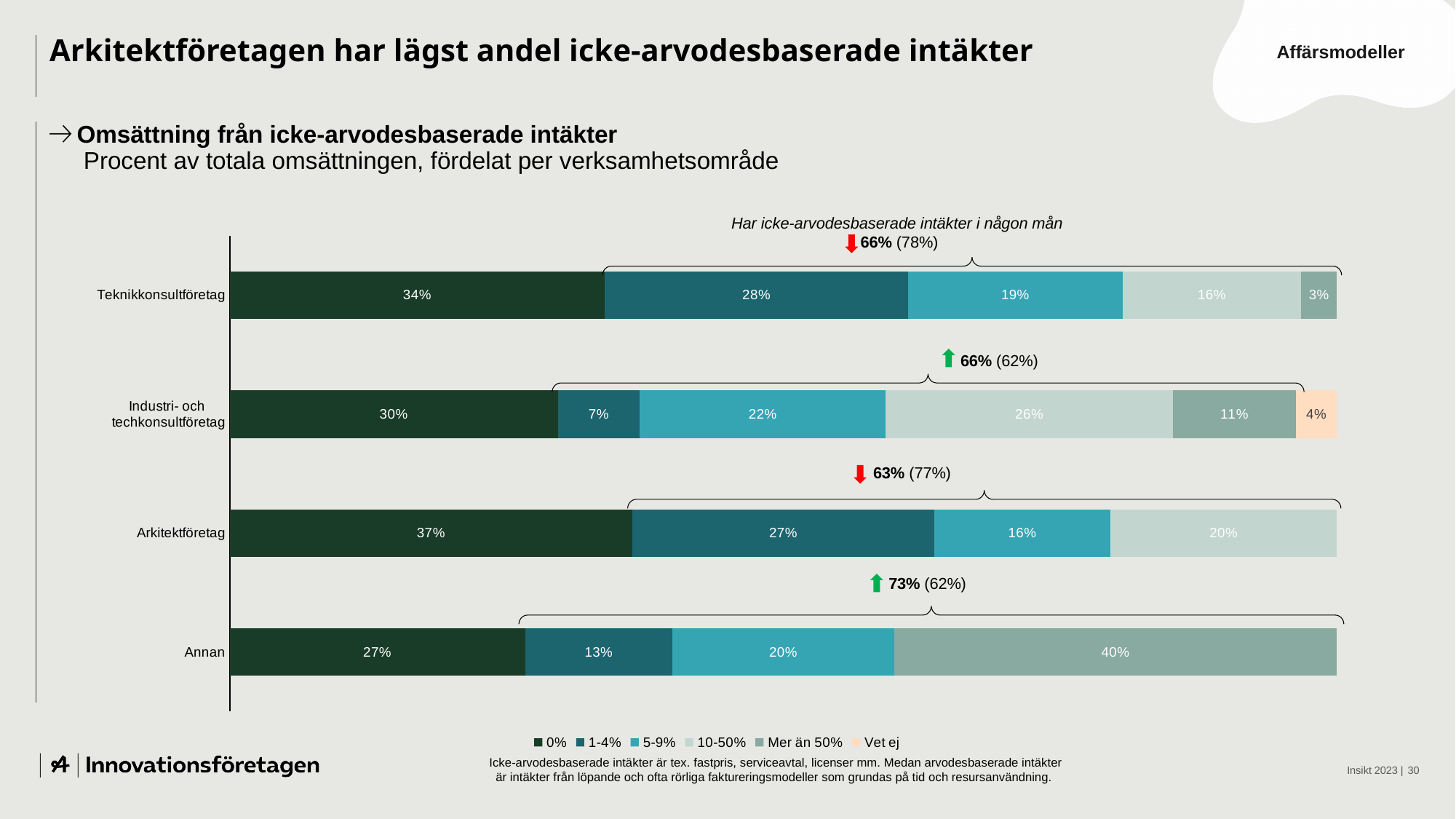
Which category has the highest value in the 0% segment? Arkitektföretag Which is larger: the 5-9% segment for Industri- och techkonsultföretag or the 5-9% segment for Arkitektföretag? Industri- och techkonsultföretag What is the value of the 0% segment for Arkitektföretag? 37% How many series does the legend list? 6 According to the annotation above the Annan bar, what share has non-fee-based income to some extent (Har icke-arvodesbaserade intäkter i någon mån)? 73% What type of chart is shown on the slide? Stacked bar chart Which category has the lowest value in the 0% segment? Annan What is the value of the 'Mer än 50%' segment for Annan? 40% How many categories (verksamhetsområden) are shown on the chart? 4 What is the value of the 1-4% segment for Industri- och techkonsultföretag? 7% What is the value of the 'Vet ej' segment for Industri- och techkonsultföretag? 4% What is the difference between the 0% segment for Arkitektföretag and the 0% segment for Annan? 10%